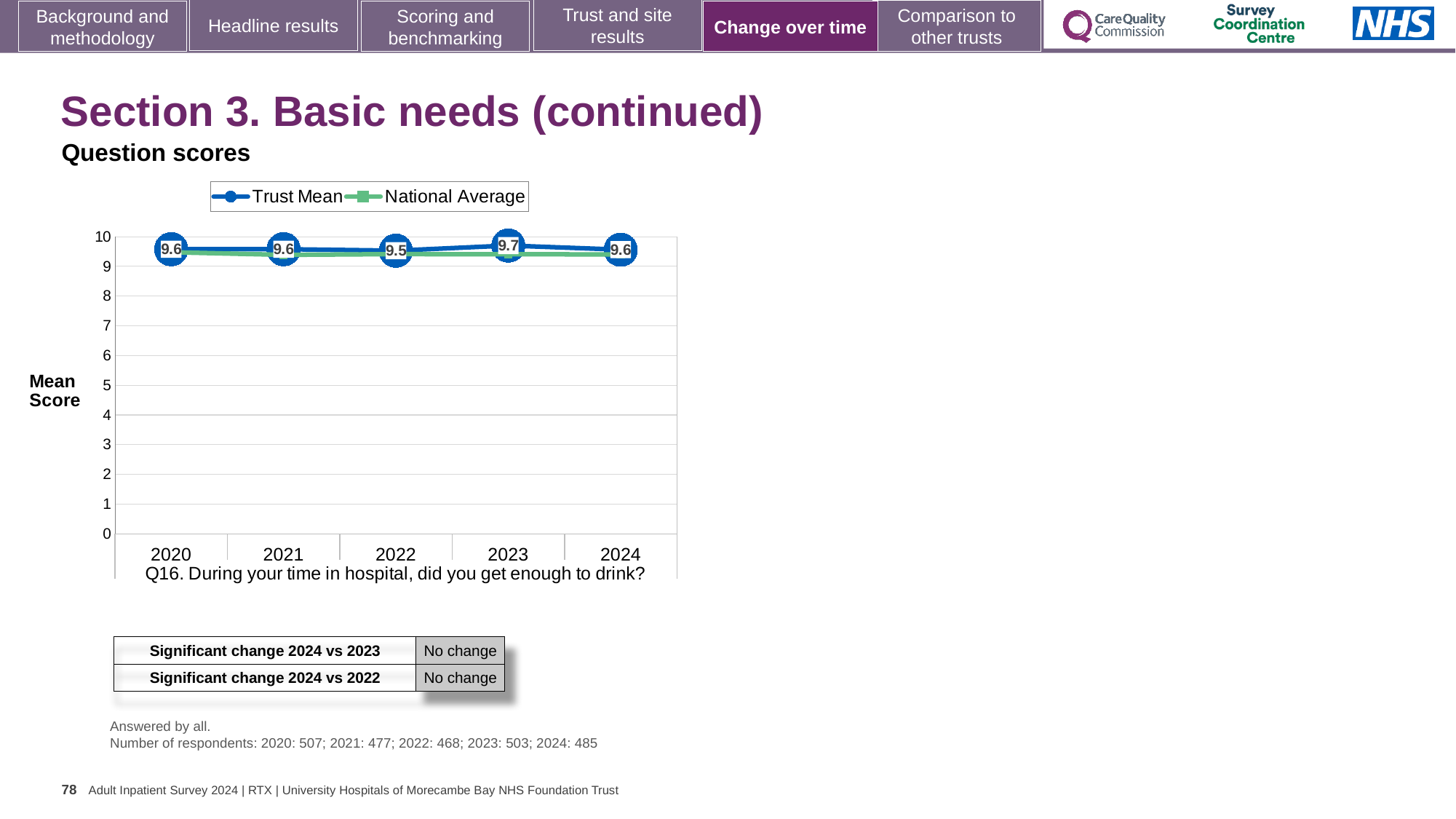
In which year is the Trust Mean score lowest? 2022 What is the difference between the Trust Mean scores for 2023 and 2022? 0.2 What kind of chart is shown? Line chart What is the Trust Mean score for 2024? 9.6 What is the Trust Mean score for 2022? 9.5 Is the National Average value for 2024 greater or less than 9? greater How many series does the legend list? 2 Which question does the chart show scores for? Q16. During your time in hospital, did you get enough to drink? What is the Trust Mean score for 2023? 9.7 How many years are plotted on the x axis? 5 In which year is the Trust Mean score highest? 2023 Which is larger, the Trust Mean score for 2023 or for 2024? 2023